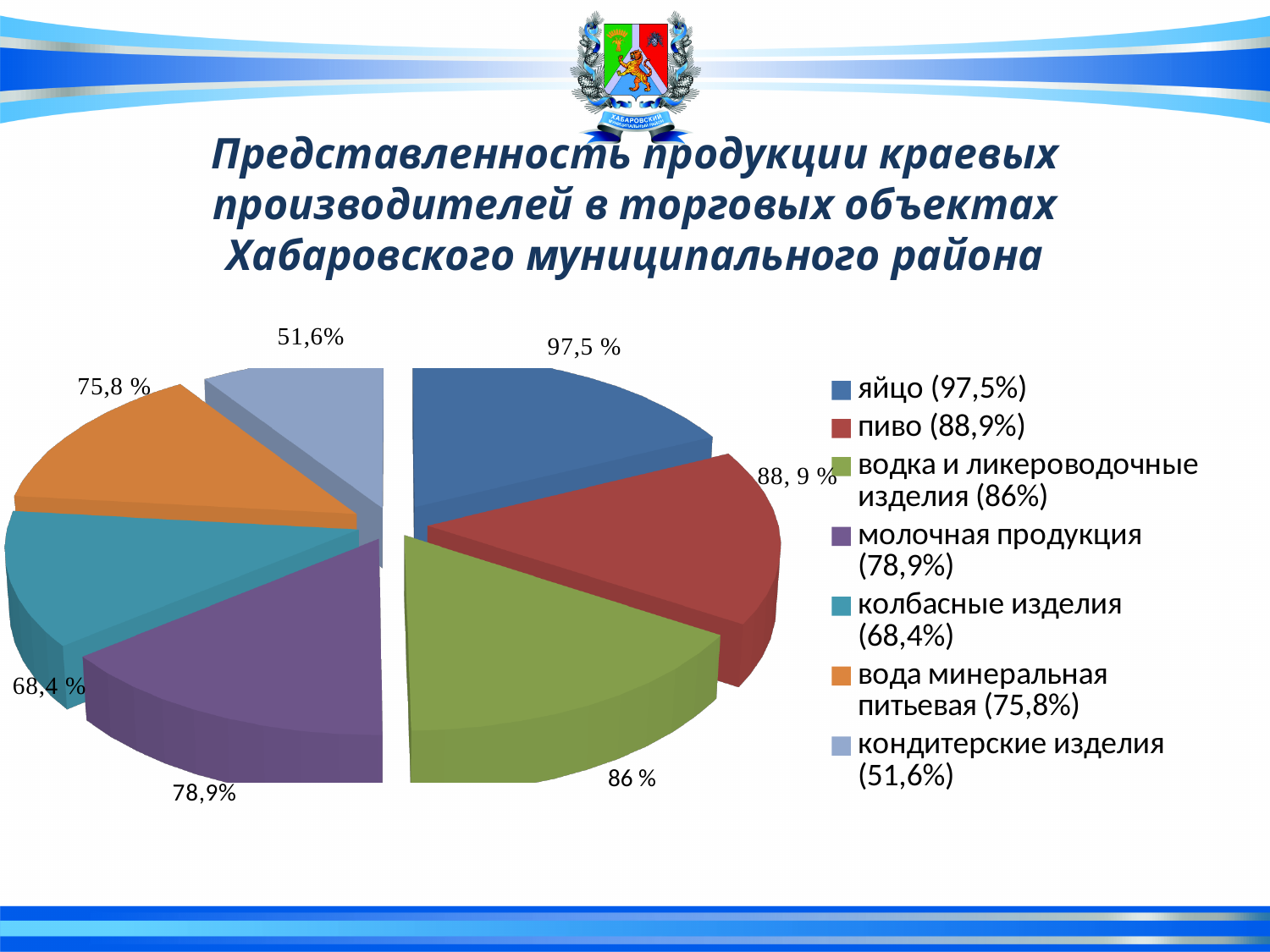
What is the value for молочная продукция? 78,9% What type of chart is shown on the slide? pie chart How many categories does the pie chart show? 7 Which category has the lowest value? кондитерские изделия What is the value for пиво? 88,9% What colour is the slice for водка и ликероводочные изделия? green What is the difference between the values for водка и ликероводочные изделия and кондитерские изделия? 34,4% What is the value for кондитерские изделия? 51,6% Which has a larger value, колбасные изделия or вода минеральная питьевая? вода минеральная питьевая Which category has the highest value? яйцо What is the difference between the values for яйцо and пиво? 8,6% What is the value for яйцо? 97,5%